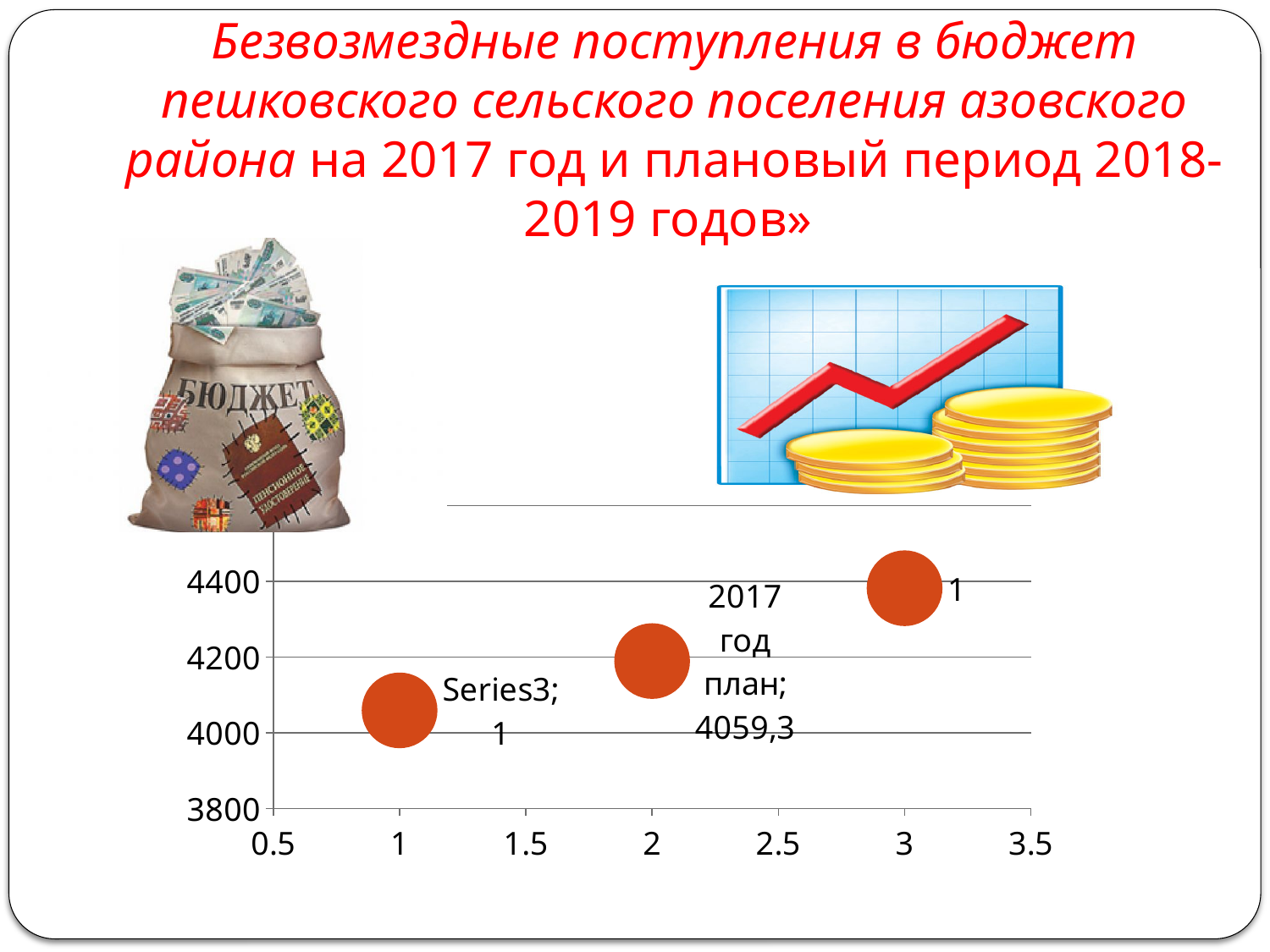
Is the value of the point at x = 2 greater or less than 4400? less At which x value is the highest point plotted? 3 Is the value of the point at x = 1 greater or less than 4200? less At which x value is the lowest point plotted? 1 What kind of chart is shown at the bottom of the slide? bubble chart Do the plotted values rise or fall as the x value increases from 1 to 3? rise Is the value of the point at x = 3 greater or less than 4200? greater What is the highest tick value shown on the vertical axis? 4400 Which point has the larger value, the one at x = 1 or the one at x = 2? x = 2 How many data points are plotted on the chart? 3 What numeric value is printed in the data label that reads "2017 год план"? 4059,3